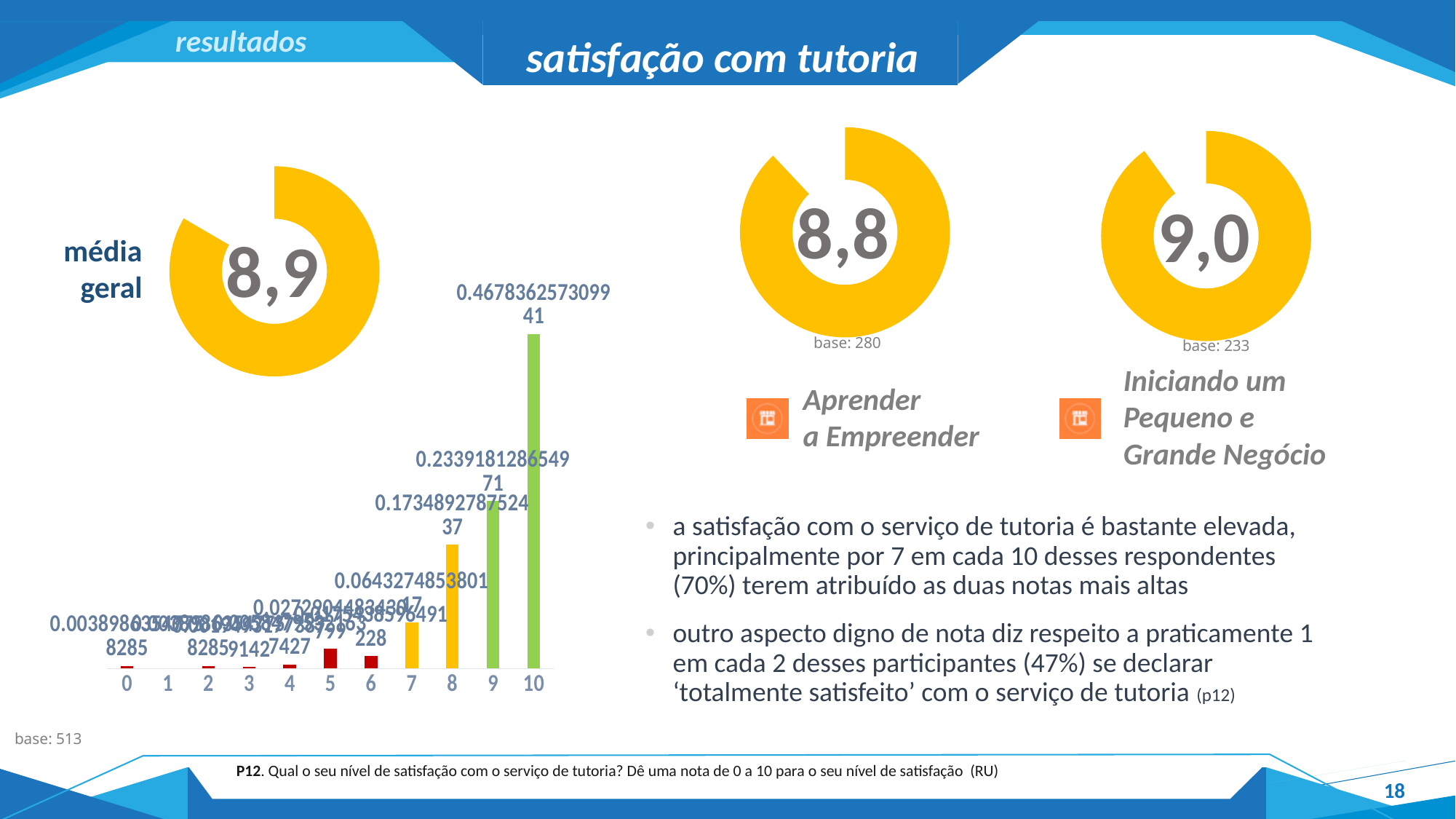
In the bar chart, what is the value labelled for score 10? 0.467836257309941 In the bar chart, which has the larger value: score 9 or score 8? 9 In the bar chart, what is the value labelled for score 9? 0.233918128654971 Do the bar values generally rise or fall as the score increases from 0 to 10? rise Which donut chart shows the higher average: 'Aprender a Empreender' or 'Iniciando um Pequeno e Grande Negócio'? Iniciando um Pequeno e Grande Negócio What colour are the bars for scores 9 and 10 in the bar chart? green What average is shown in the donut chart for 'Aprender a Empreender'? 8,8 How many score categories are shown on the x axis of the bar chart? 11 What kind of chart is used to show the distribution of satisfaction scores from 0 to 10? bar chart In the bar chart, which score category has the highest value? 10 What is the 'média geral' shown in the large donut chart on the left? 8,9 In the bar chart, what is the value labelled for score 8? 0.173489278752437